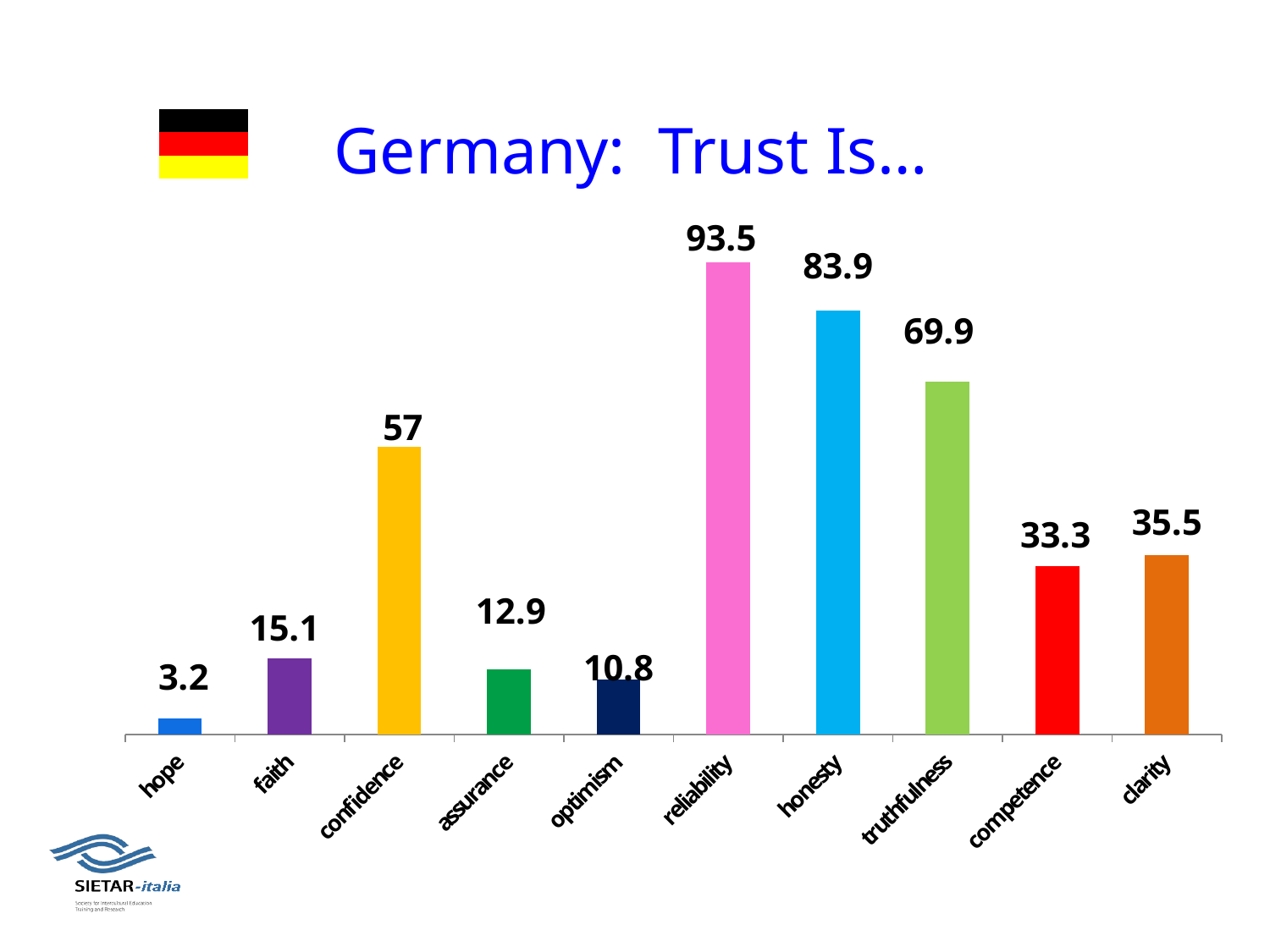
What is the value for hope? 3.2 Which is larger, the value for truthfulness or the value for confidence? truthfulness Which is larger, the value for faith or the value for assurance? faith What is the difference between the values for clarity and competence? 2.2 What is the title of the slide? Germany: Trust Is... What is the value for reliability? 93.5 Which category has the highest value? reliability What is the difference between the values for reliability and honesty? 9.6 How many categories are shown on the x axis? 10 What is the value for confidence? 57 Which category has the lowest value? hope What kind of chart is shown on the slide? bar chart